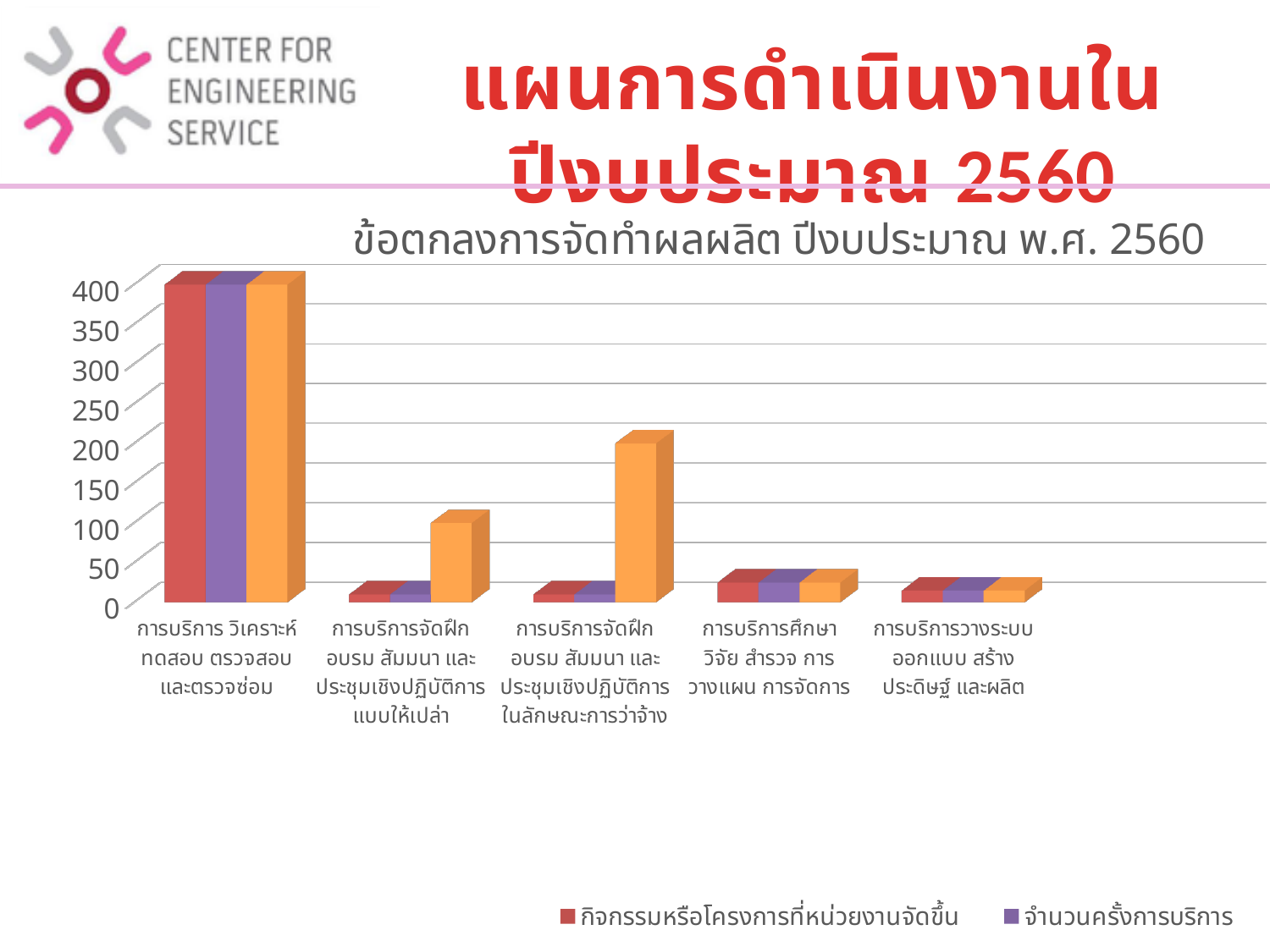
How many series entries does the legend list? 2 Is the value of the purple bar (จำนวนครั้งการบริการ) for การบริการวางระบบ ออกแบบ สร้าง ประดิษฐ์ และผลิต greater or less than 100? less What kind of chart is shown on the slide? bar chart Which series is shown in red according to the legend? กิจกรรมหรือโครงการที่หน่วยงานจัดขึ้น What is the title of the chart? ข้อตกลงการจัดทำผลผลิต ปีงบประมาณ พ.ศ. 2560 Is the value of the red bar (กิจกรรมหรือโครงการที่หน่วยงานจัดขึ้น) for การบริการ วิเคราะห์ ทดสอบ ตรวจสอบ และตรวจซ่อม greater or less than 350? greater Is the value of the orange bar for การบริการจัดฝึกอบรม สัมมนา และประชุมเชิงปฏิบัติการแบบให้เปล่า greater or less than 150? less How many categories are shown along the x axis of the chart? 5 Which category has the highest values in the chart? การบริการ วิเคราะห์ ทดสอบ ตรวจสอบ และตรวจซ่อม Which has the larger orange bar: การบริการจัดฝึกอบรม สัมมนา และประชุมเชิงปฏิบัติการแบบให้เปล่า or การบริการจัดฝึกอบรม สัมมนา และประชุมเชิงปฏิบัติการในลักษณะการว่าจ้าง? การบริการจัดฝึกอบรม สัมมนา และประชุมเชิงปฏิบัติการในลักษณะการว่าจ้าง